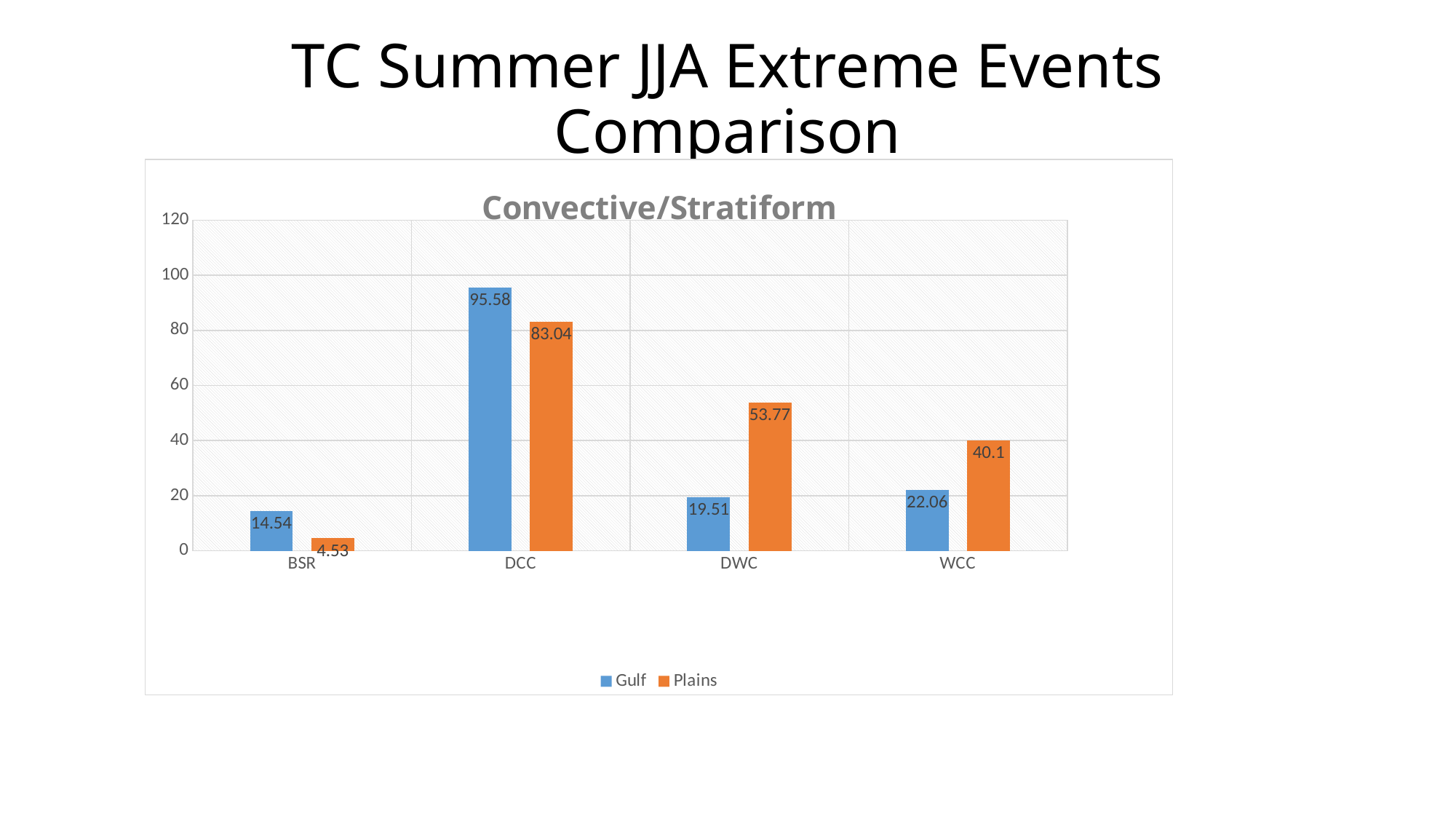
What is the difference between the Gulf and Plains values for DCC? 12.54 Which category has the highest Plains value? DCC What is the Plains value for BSR? 4.53 What kind of chart is shown? bar chart How many categories are shown on the x axis? 4 How many series does the legend list? 2 Which is larger for DWC, the Gulf value or the Plains value? Plains What is the Gulf value for DCC? 95.58 What is the Gulf value for WCC? 22.06 Which category has the lowest Gulf value? BSR What is the Plains value for DWC? 53.77 Is the Plains value for WCC greater or less than 20? greater